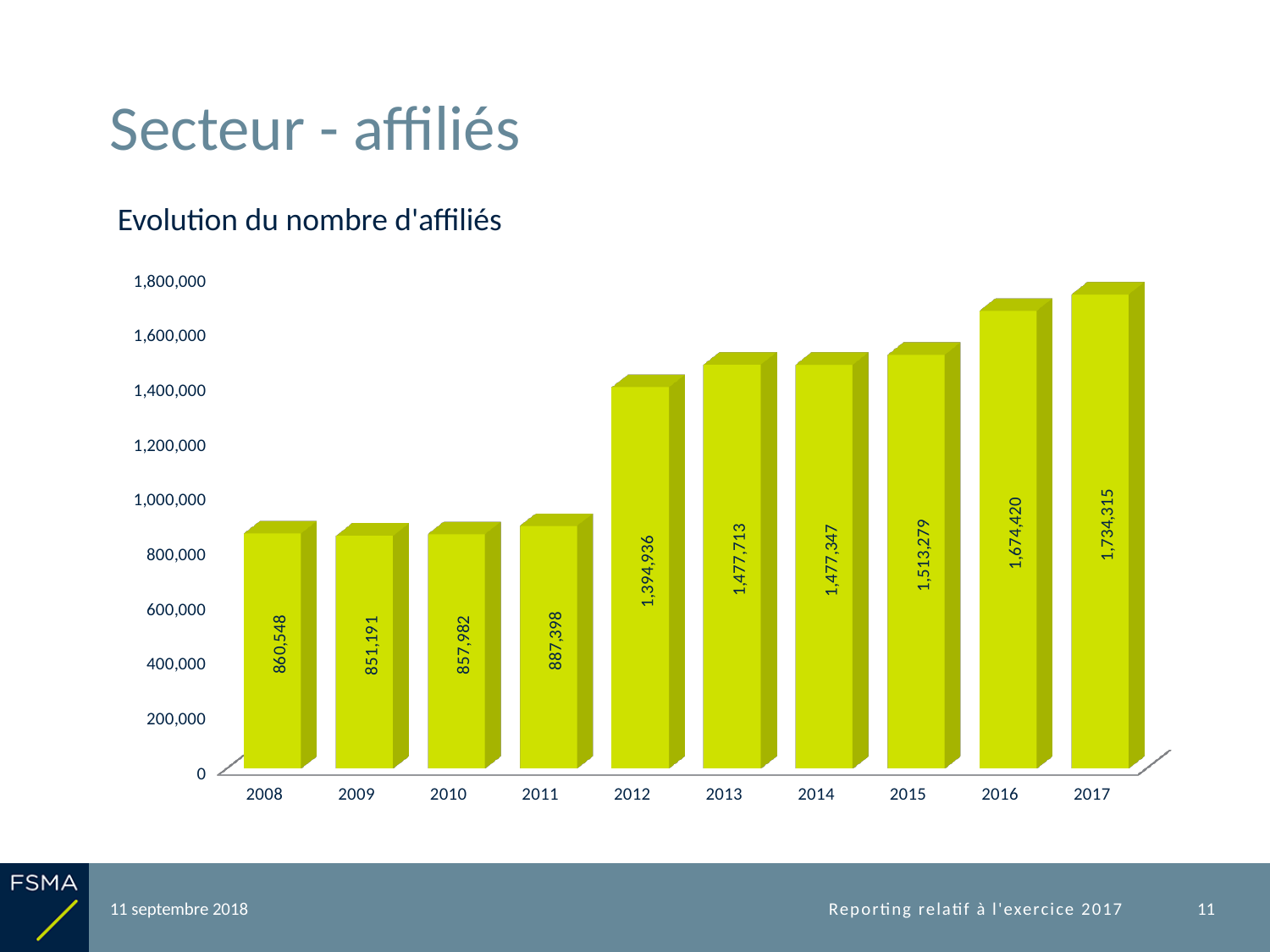
What is the number of affiliés in 2008? 860,548 Which year has the highest number of affiliés? 2017 What is the difference between the number of affiliés in 2012 and in 2011? 507,538 What is the number of affiliés in 2012? 1,394,936 Which year has more affiliés, 2015 or 2011? 2015 What is the difference between the number of affiliés in 2017 and in 2016? 59,895 What is the title of the chart? Evolution du nombre d'affiliés What type of chart is shown on the slide? Bar chart Which year has the lowest number of affiliés? 2009 What is the number of affiliés in 2017? 1,734,315 Is the value for 2016 greater or less than 1,600,000? greater How many years are shown on the x axis of the chart? 10